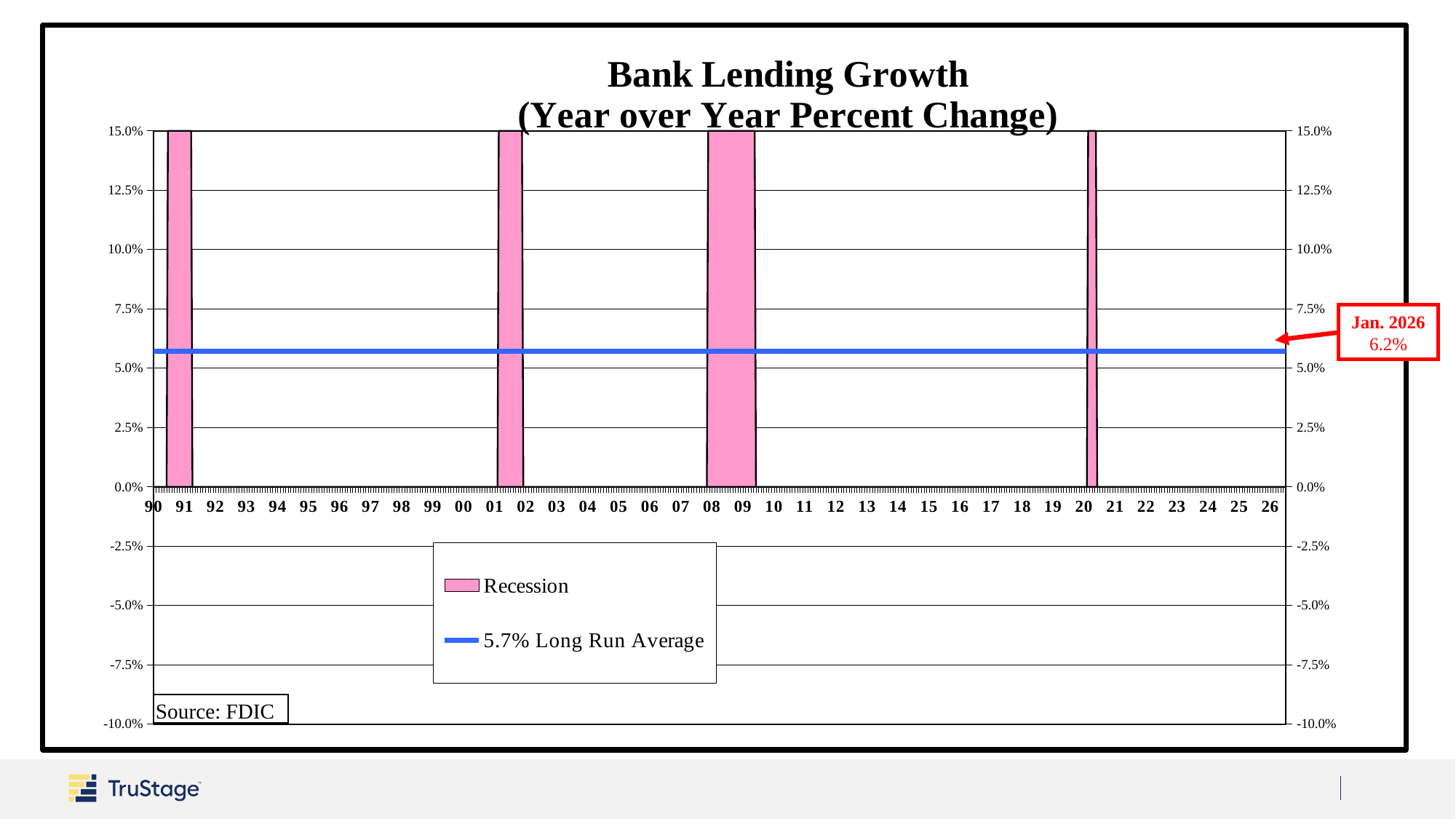
How many entries does the chart's legend list? 2 What source is cited for the chart's data? FDIC What is the title of the chart? Bank Lending Growth (Year over Year Percent Change) How many recession bars are shaded on the chart? 4 Is the long run average line greater or less than 7.5%? less Which is larger, the Jan. 2026 value or the long run average? Jan. 2026 value What is the difference between the Jan. 2026 value and the 5.7% long run average? 0.5% Does the 5.7% Long Run Average line rise, fall, or stay flat across the x axis? stays flat How many year labels are shown on the x axis? 37 What value is annotated for Jan. 2026? 6.2% Is the long run average line greater or less than 5.0%? greater What is the long run average value shown in the legend? 5.7%